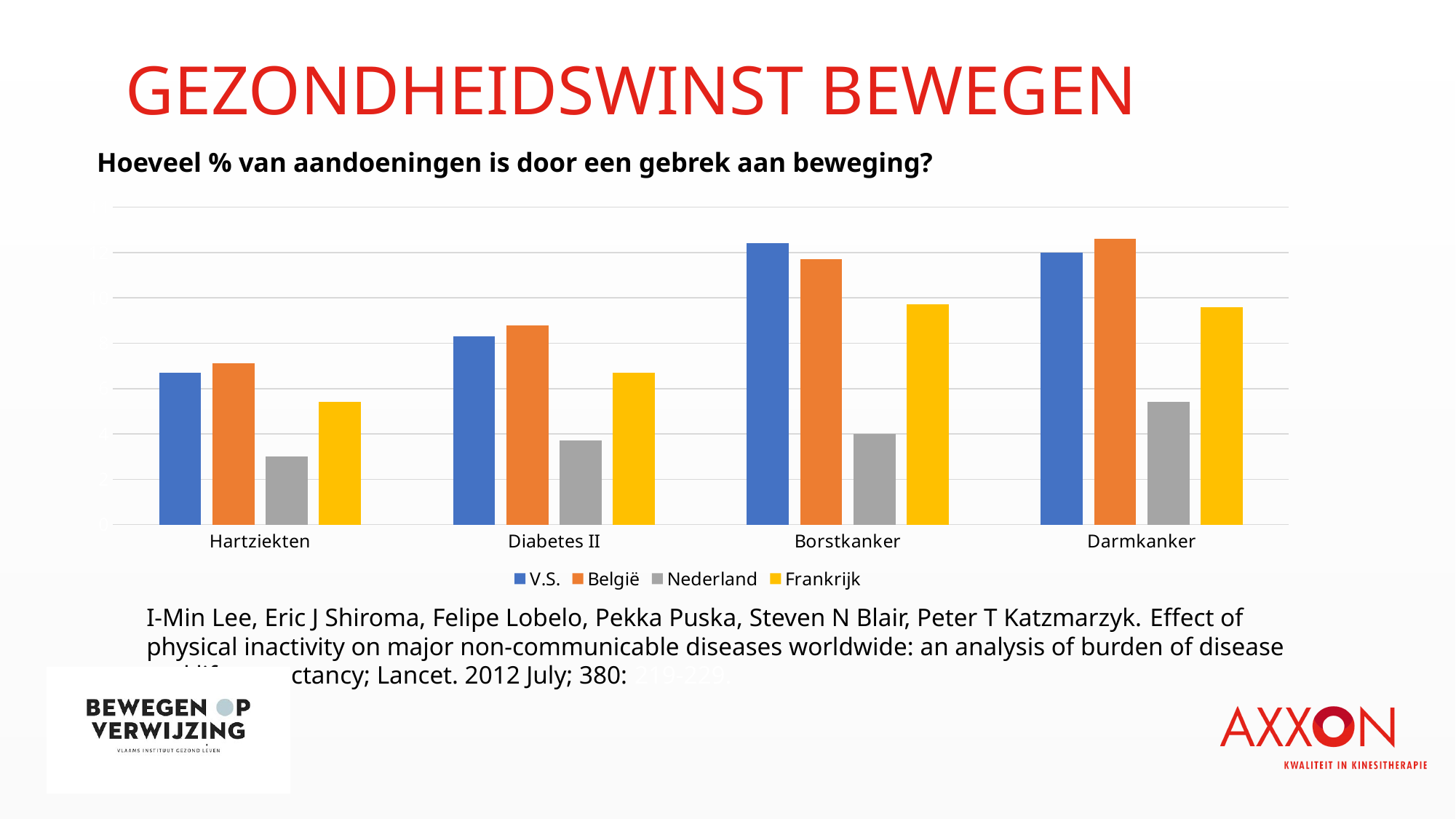
In which disease category does Nederland have its highest value? Darmkanker Which country has the lowest value for Borstkanker? Nederland What kind of chart is shown on the slide? bar chart Which country has the highest value for Hartziekten? België For V.S., which is larger: the value for Hartziekten or the value for Borstkanker? Borstkanker Which country has the highest value for Darmkanker? België Which countries are listed in the chart legend? V.S., België, Nederland, Frankrijk Do the values for Nederland rise or fall from Hartziekten to Darmkanker along the x axis? rise How many series does the chart legend list? 4 How many disease categories are shown on the x axis of the chart? 4 For Diabetes II, which is larger: the value for Frankrijk or the value for Nederland? Frankrijk